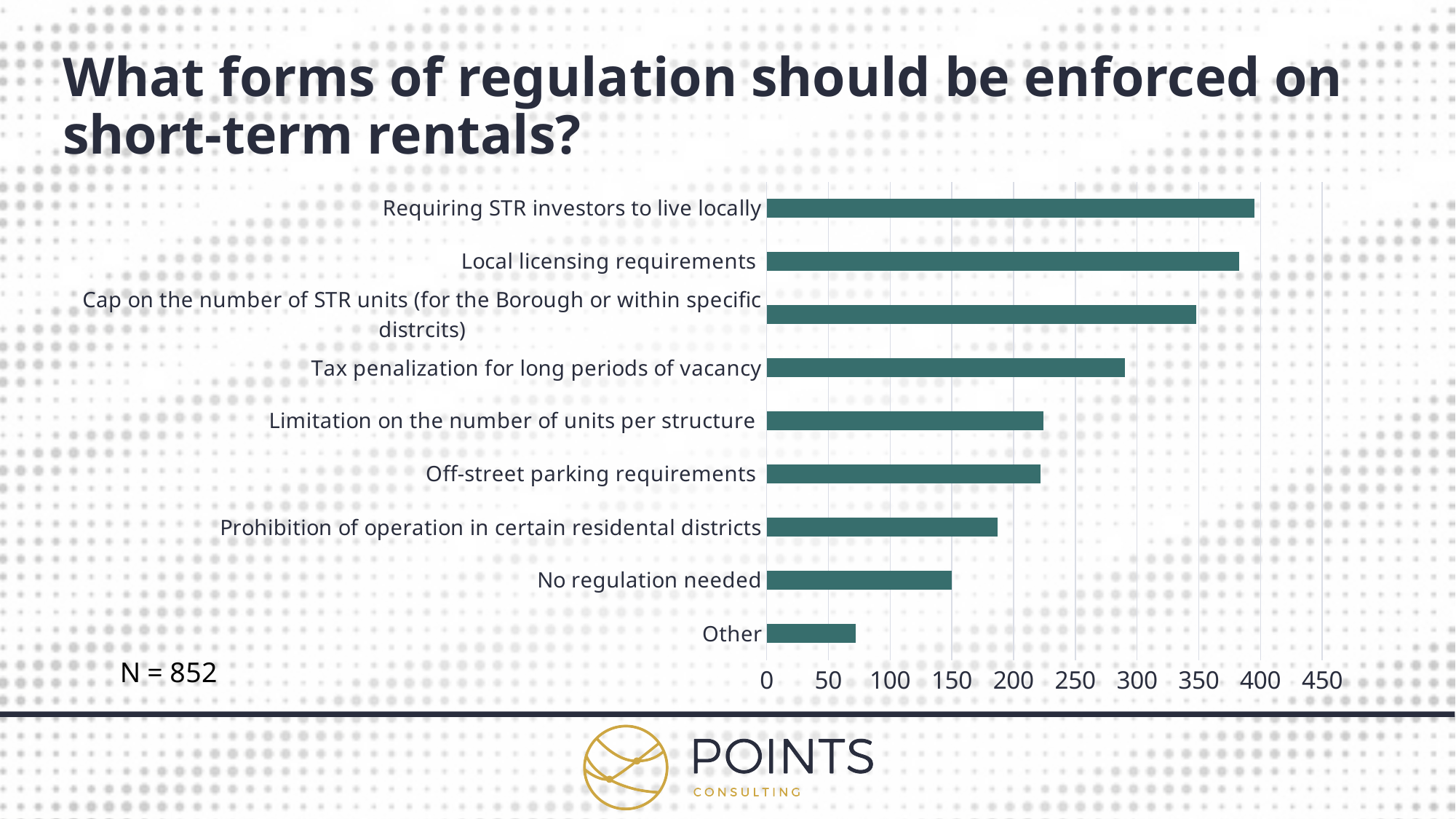
Is the value for Tax penalization for long periods of vacancy greater or less than 250? greater Which category has the lowest value? Other Is the value for Cap on the number of STR units greater or less than 300? greater Which category has the highest value? Requiring STR investors to live locally Is the value for Requiring STR investors to live locally greater or less than 350? greater Which is larger: the value for Tax penalization for long periods of vacancy or the value for Prohibition of operation in certain residental districts? Tax penalization for long periods of vacancy How many regulation categories are plotted in the chart? 9 What kind of chart is shown on the slide? bar chart What sample size (N) is stated on the slide? N = 852